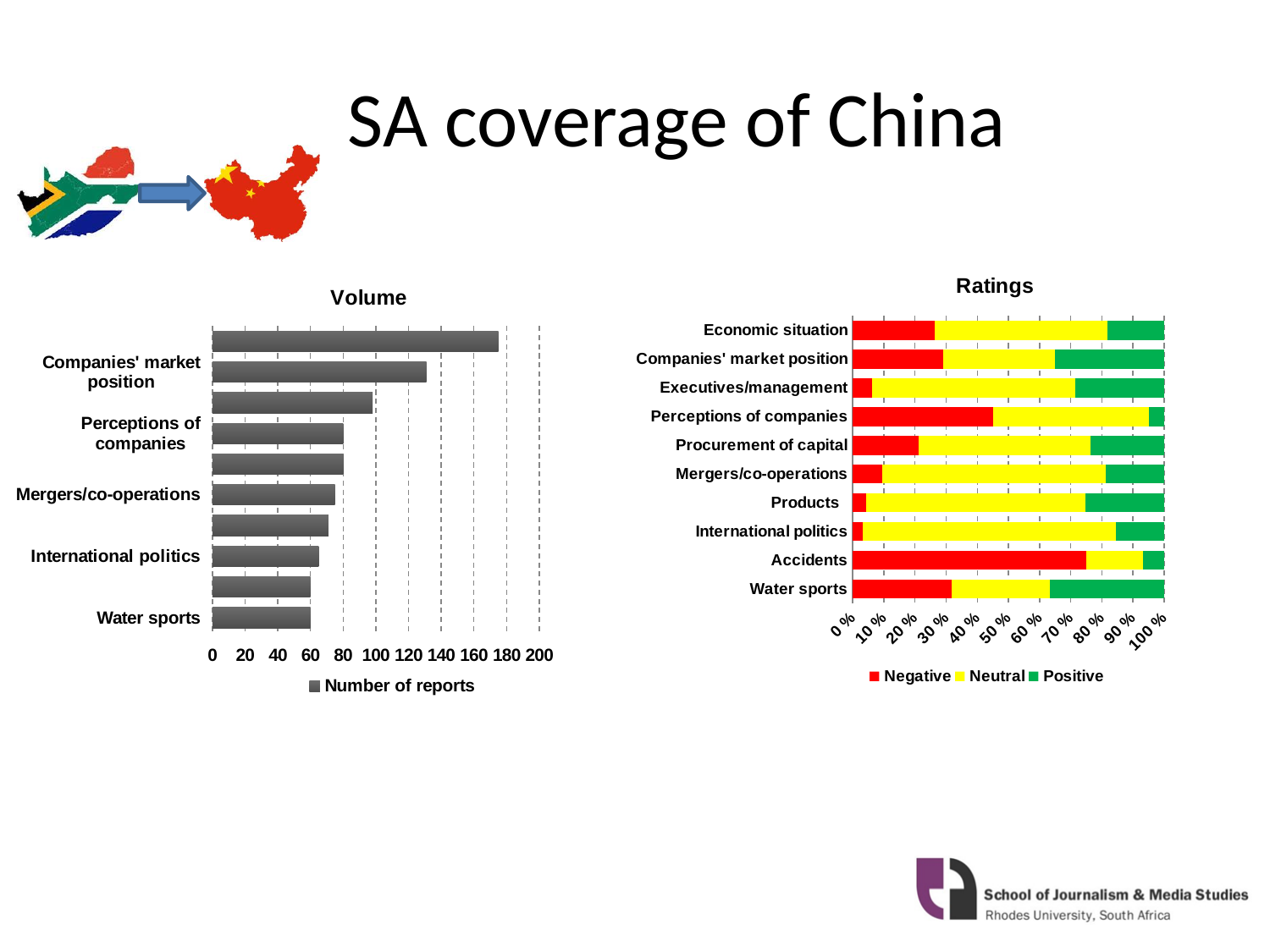
In the Volume chart, is the value for Mergers/co-operations greater or less than 100? less How many bars does the Volume chart show? 10 What is the legend entry of the Volume chart? Number of reports In the Ratings chart, is the Negative share for Accidents greater or less than 70 %? greater In the Volume chart, which has more reports: Companies' market position or Water sports? Companies' market position In the Volume chart, is the value for International politics greater or less than 80? less What kind of chart is the Volume chart on the left? Bar chart In the Ratings chart, which category has the largest Negative share? Accidents In the Ratings chart, which has a larger Negative share: Perceptions of companies or Executives/management? Perceptions of companies How many series does the legend of the Ratings chart list? 3